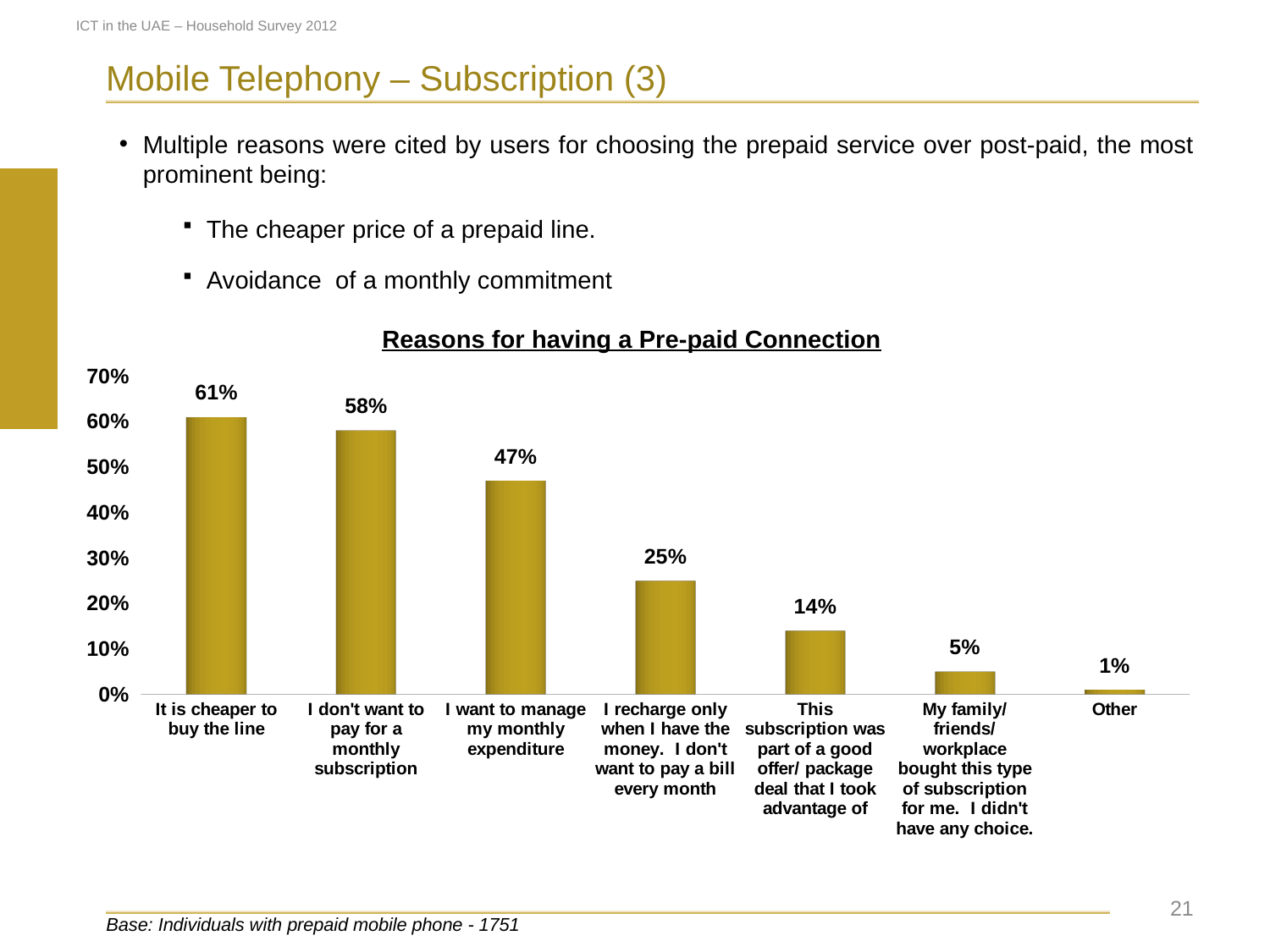
What is the difference between "I recharge only when I have the money. I don't want to pay a bill every month" and "This subscription was part of a good offer/ package deal that I took advantage of"? 11% What is the title of the chart? Reasons for having a Pre-paid Connection Which reason has the lowest percentage in the chart? Other What type of chart is used to show the reasons for having a pre-paid connection? Bar chart What is the difference between "It is cheaper to buy the line" and "I don't want to pay for a monthly subscription"? 3% Is the value for "This subscription was part of a good offer/ package deal that I took advantage of" greater or less than 20%? less Which reason has the highest percentage in the chart? It is cheaper to buy the line How many reasons (categories) are shown in the chart? 7 Which is larger: the value for "I want to manage my monthly expenditure" or the value for "I recharge only when I have the money. I don't want to pay a bill every month"? I want to manage my monthly expenditure What percentage of respondents cited "It is cheaper to buy the line" as a reason for having a pre-paid connection? 61% What is the value for "I want to manage my monthly expenditure"? 47% What percentage is shown for "Other"? 1%